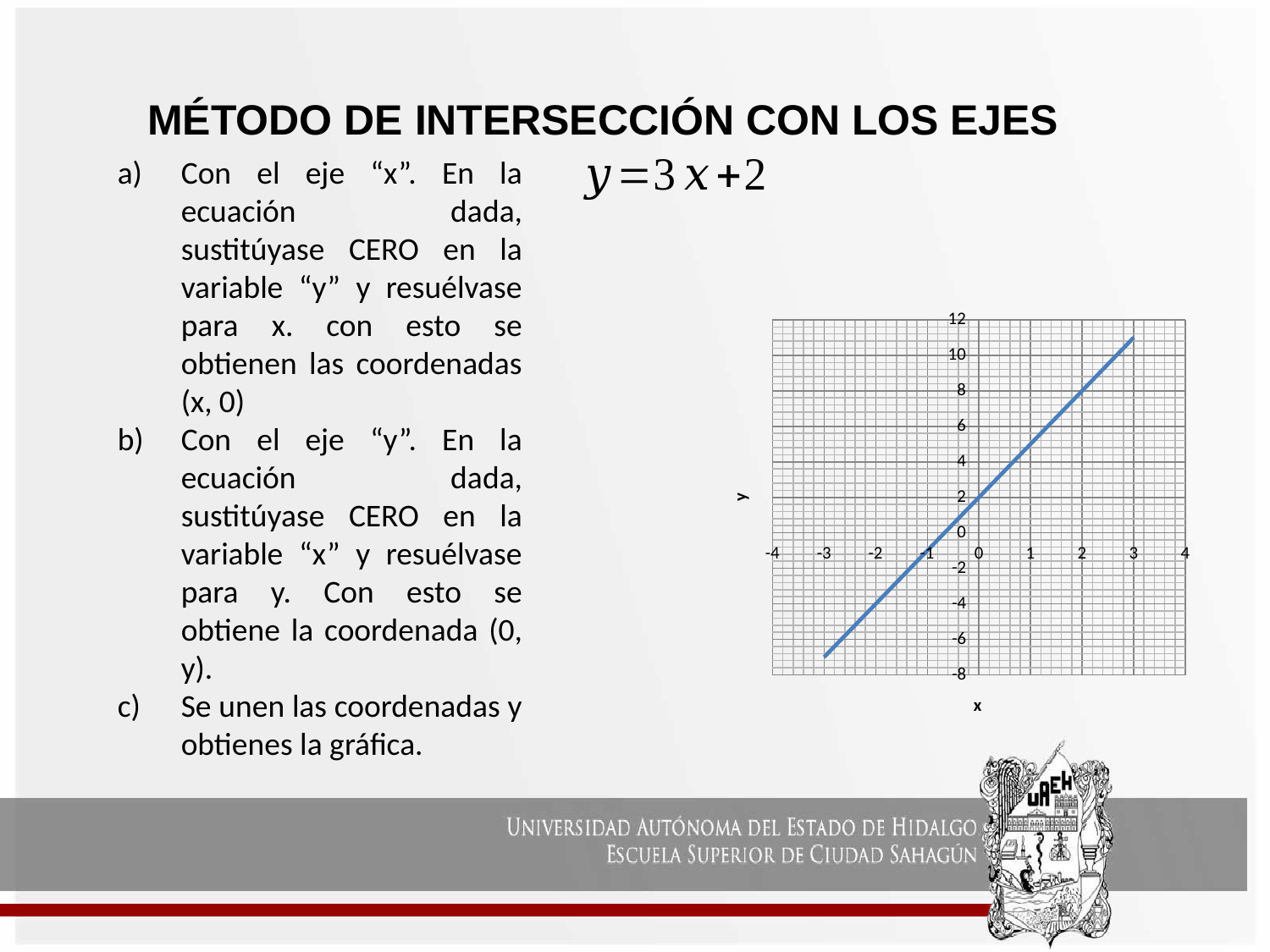
Do the values of the line rise or fall as x increases? rise Is the value of y on the line at x = 1 greater or less than 4? greater Is the value of y on the line at x = 3 greater or less than 10? greater What is the label of the horizontal axis of the chart? x Which is larger, the value of y on the line at x = 2 or at x = -2? x = 2 Is the value of y on the line at x = -3 greater or less than -6? less What is the value of y on the line at x = -2? -4 What is the value of y on the line at x = 2? 8 What kind of chart is shown on the slide? line chart What is the highest value shown on the vertical axis of the chart? 12 What is the value of y where the line crosses the y axis (x = 0)? 2